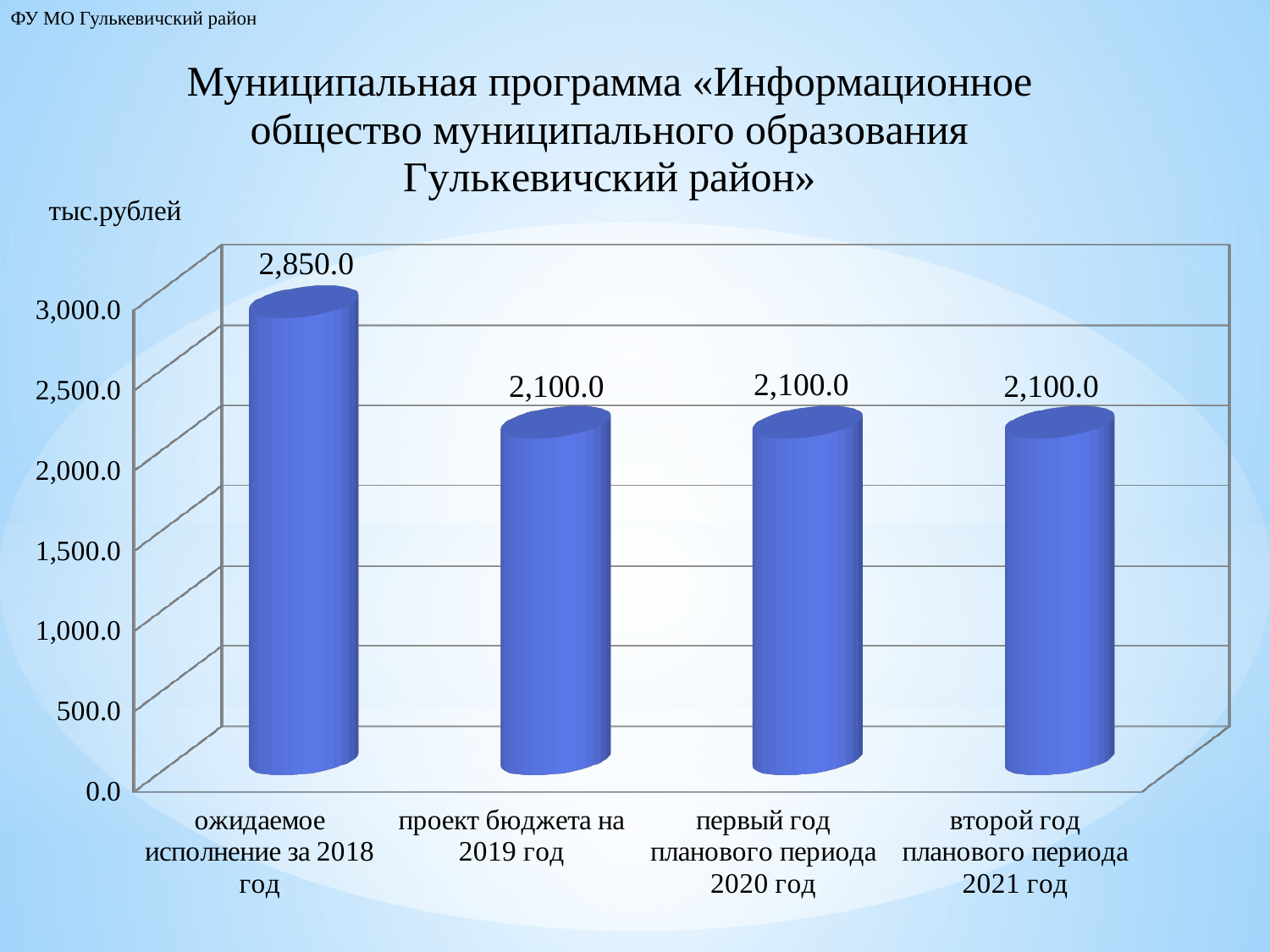
What is the value for 'проект бюджета на 2019 год'? 2,100.0 What is the total of the values for 2019, 2020 and 2021? 6,300.0 What is the value for 'ожидаемое исполнение за 2018 год'? 2,850.0 How many categories are shown on the chart? 4 What unit is indicated above the vertical axis of the chart? тыс.рублей What kind of chart is shown on the slide? bar chart Is the value for 'первый год планового периода 2020 год' greater or less than 2,500.0? less Which is larger: the value for 'ожидаемое исполнение за 2018 год' or the value for 'первый год планового периода 2020 год'? ожидаемое исполнение за 2018 год Do the values rise or fall from the first category to the second category? fall What is the difference between the value for 'ожидаемое исполнение за 2018 год' and the value for 'проект бюджета на 2019 год'? 750.0 What is the value for 'второй год планового периода 2021 год'? 2,100.0 Which category has the highest value? ожидаемое исполнение за 2018 год